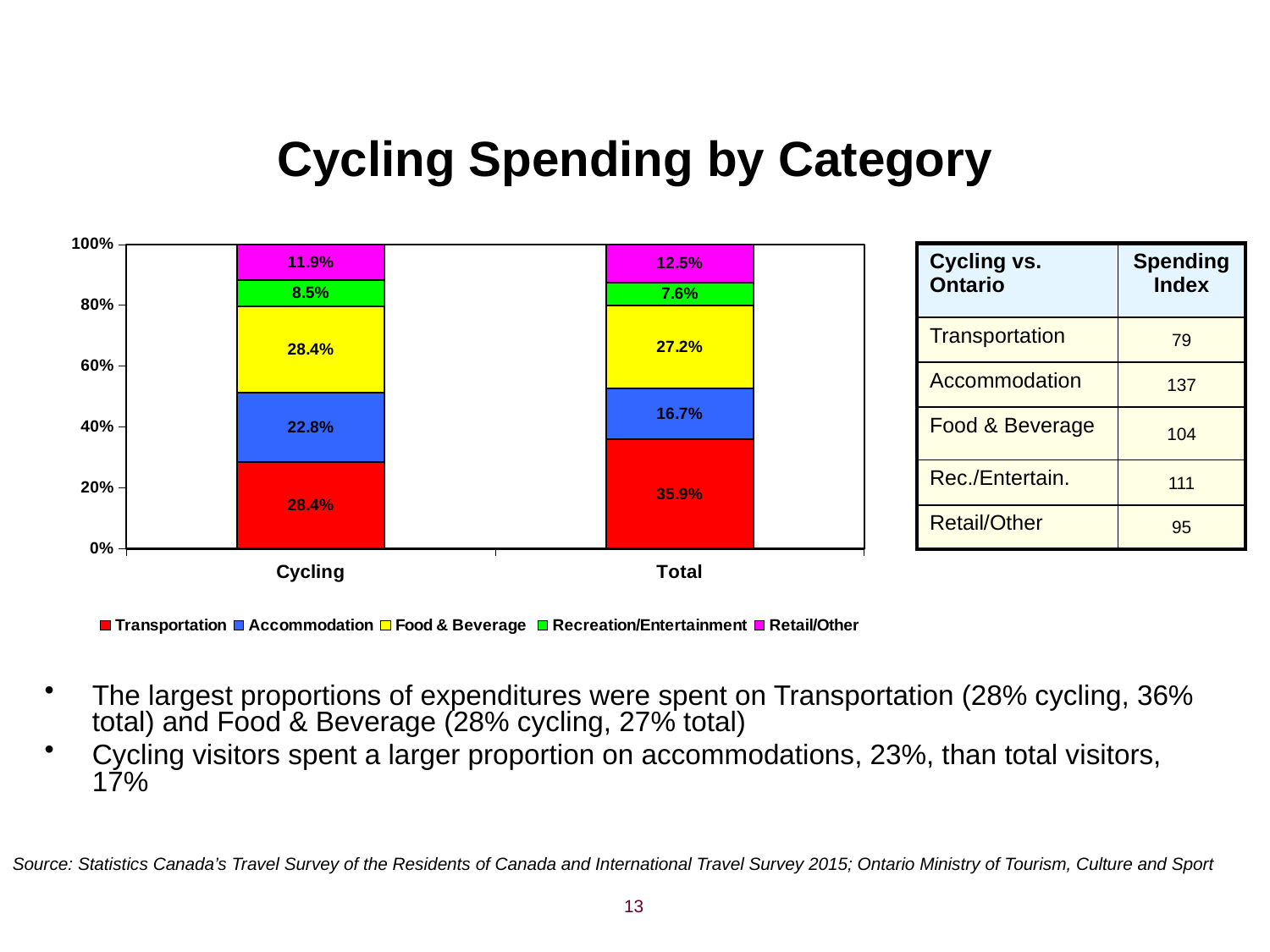
What percentage of Cycling spending goes to Accommodation? 22.8% Is the Retail/Other share larger for Cycling or for Total? Total What colour represents Transportation in the chart? Red Which category has the smallest share in the Cycling bar? Recreation/Entertainment What is the Food & Beverage share for the Total bar? 27.2% What is the Retail/Other share for the Cycling bar? 11.9% What kind of chart is shown on the slide? Stacked bar chart What percentage of Total spending goes to Transportation? 35.9% How many bars (categories) are shown on the x axis? 2 By how many percentage points does the Accommodation share for Cycling exceed that for Total? 6.1 percentage points Which category has the largest share in the Total bar? Transportation How many series does the legend list? 5